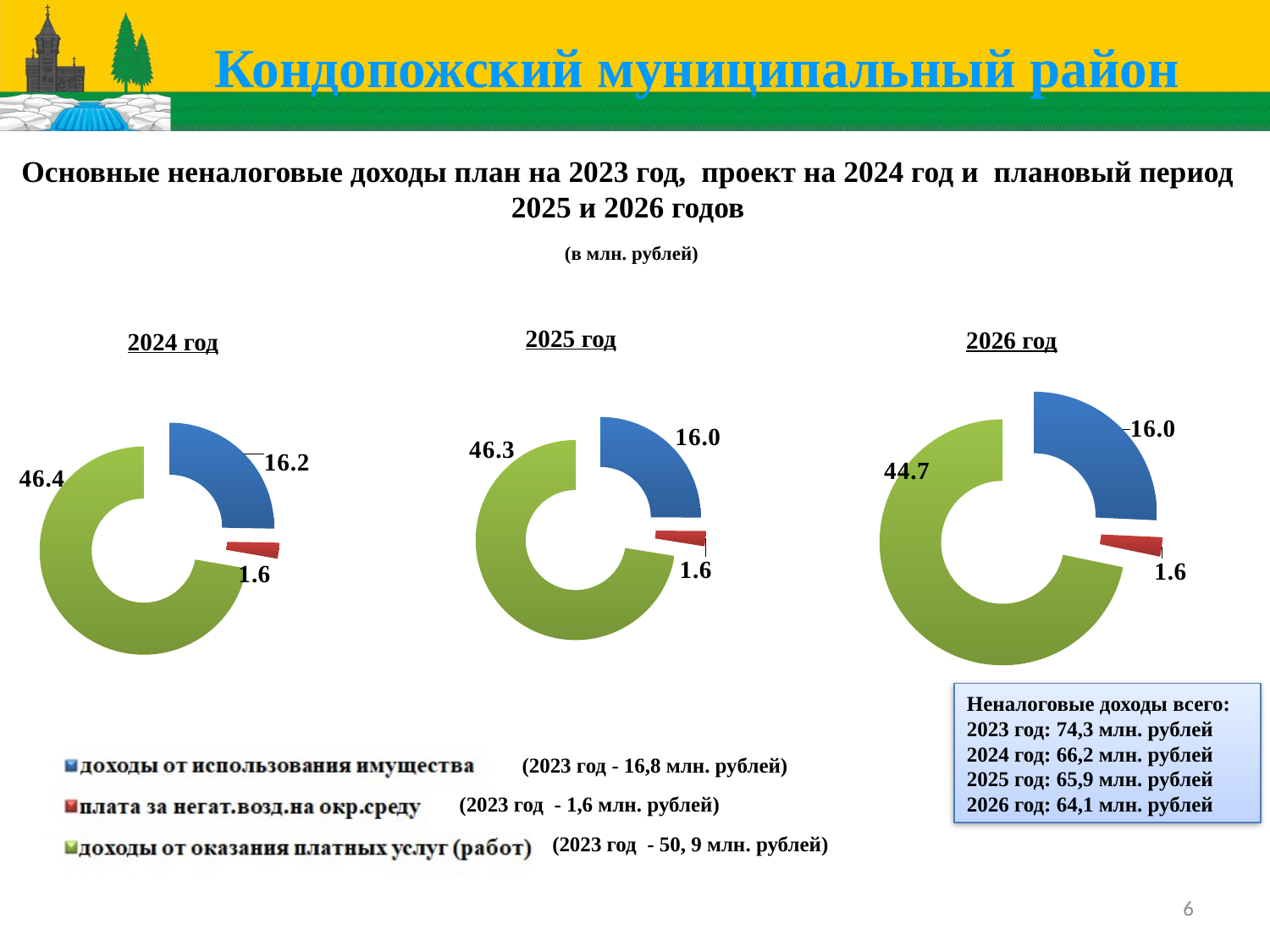
How many entries does the legend list? 3 In the 2025 год chart, what is the difference between доходы от оказания платных услуг (работ) and доходы от использования имущества? 30.3 In the 2026 год chart, which category has the largest value? доходы от оказания платных услуг (работ) Which is larger in the 2026 год chart: доходы от использования имущества or плата за негат.возд.на окр.среду? доходы от использования имущества In the 2024 год chart, what is the value for доходы от использования имущества? 16.2 In the 2025 год chart, what is the value for доходы от оказания платных услуг (работ)? 46.3 What kind of chart is the 2025 год chart? doughnut (pie) chart How many slices does the 2024 год chart have? 3 What is the total of the three values shown in the 2026 год chart? 62.3 In the 2024 год chart, which category has the smallest value? плата за негат.возд.на окр.среду In the 2026 год chart, what is the value for плата за негат.возд.на окр.среду? 1.6 Which colour represents доходы от оказания платных услуг (работ) in the charts? green